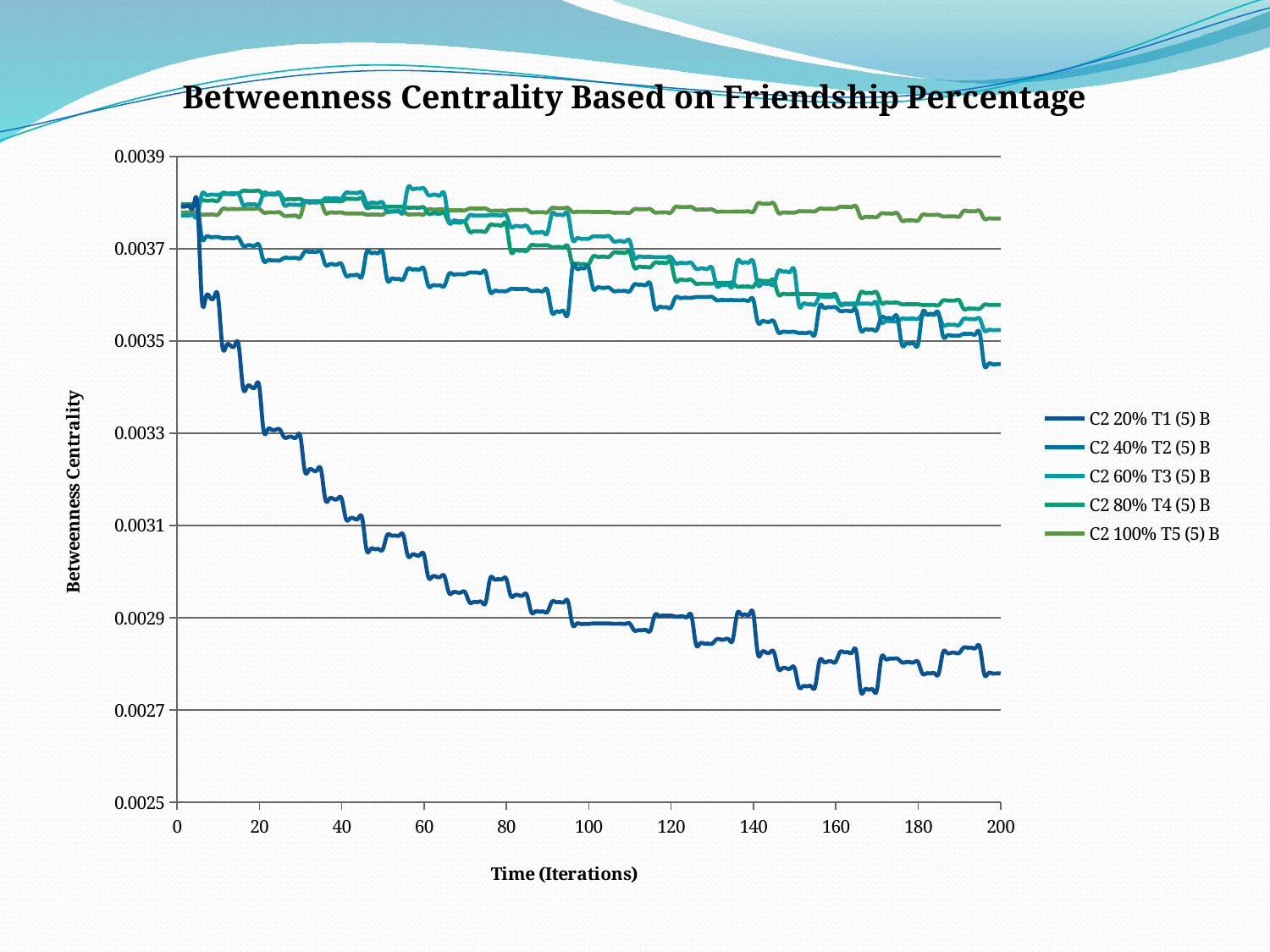
At iteration 200, which is larger: the value for C2 100% T5 (5) B or the value for C2 20% T1 (5) B? C2 100% T5 (5) B How many series does the legend list? 5 Is the value for C2 20% T1 (5) B at iteration 60 greater or less than 0.0031? less Does the value of the C2 20% T1 (5) B series rise or fall as the iterations increase? fall Which series has the highest value at iteration 200? C2 100% T5 (5) B Which series has the lowest value at iteration 200? C2 20% T1 (5) B What is the label of the x axis? Time (Iterations) Is the value for C2 20% T1 (5) B at iteration 200 greater or less than 0.0029? less What kind of chart is shown on the slide? line chart At iteration 100, which is larger: the value for C2 40% T2 (5) B or the value for C2 20% T1 (5) B? C2 40% T2 (5) B What is the title of the chart? Betweenness Centrality Based on Friendship Percentage Is the value for C2 100% T5 (5) B at iteration 200 greater or less than 0.0037? greater